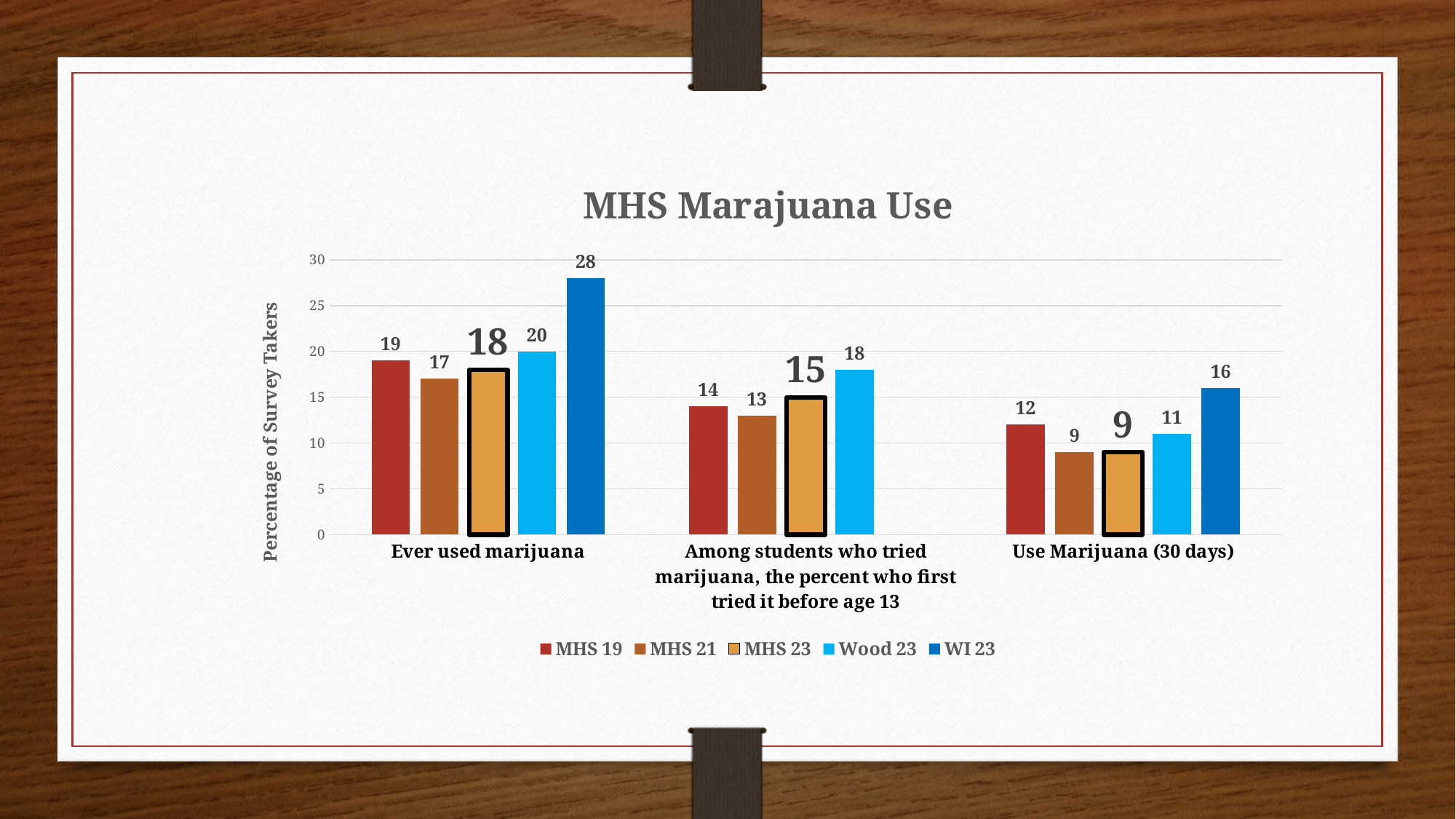
What is the difference between the WI 23 and MHS 23 values in the 'Ever used marijuana' category? 10 What is the label of the vertical axis? Percentage of Survey Takers In the 'Use Marijuana (30 days)' category, which is larger: MHS 19 or Wood 23? MHS 19 What is the value for MHS 23 in the 'Use Marijuana (30 days)' category? 9 Which series has the lowest value in the 'Among students who tried marijuana, the percent who first tried it before age 13' category? MHS 21 Which series has the highest value in the 'Ever used marijuana' category? WI 23 What is the value for Wood 23 in the 'Among students who tried marijuana, the percent who first tried it before age 13' category? 18 What is the value for WI 23 in the 'Ever used marijuana' category? 28 What is the title of the chart? MHS Marajuana Use How many series does the legend list? 5 What kind of chart is shown on the slide? Bar chart How many categories are shown on the x axis? 3